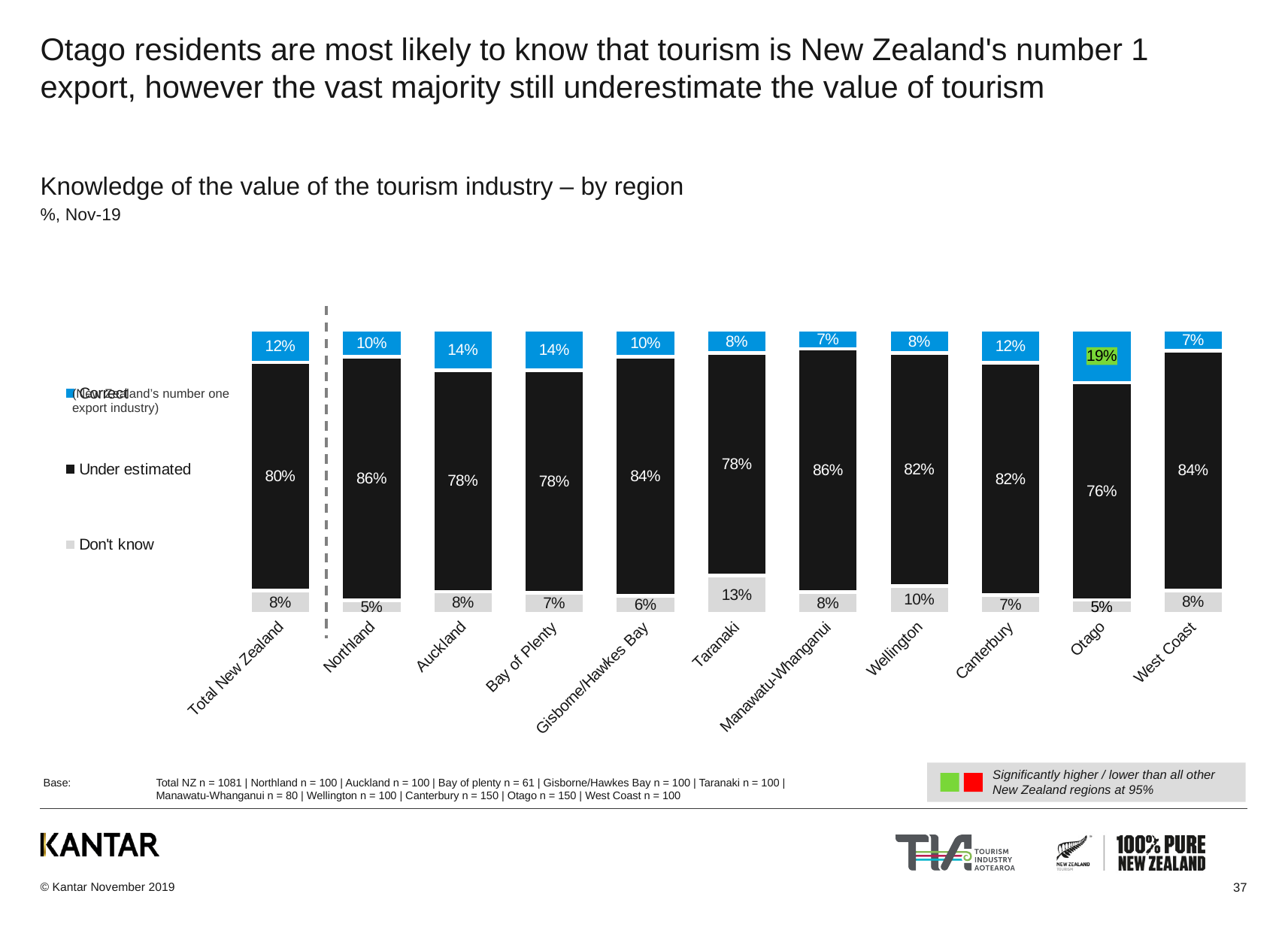
What is the total of the stacked bar for Canterbury? 101% What percentage of Otago residents correctly identified tourism as New Zealand's number one export industry? 19% How many series does the legend list? 3 What is the difference between the 'Correct' percentage for Otago and for Total New Zealand? 7% How many regions (including Total New Zealand) are shown on the x axis? 11 Which is larger: the 'Under estimated' value for Wellington or for Auckland? Wellington Which region has the highest 'Don't know' percentage? Taranaki What kind of chart is shown on the slide? Stacked bar chart What is the 'Don't know' value for Taranaki? 13% Which region has the lowest 'Under estimated' percentage? Otago What is the 'Under estimated' value for Northland? 86% Which region has the highest 'Correct' percentage? Otago